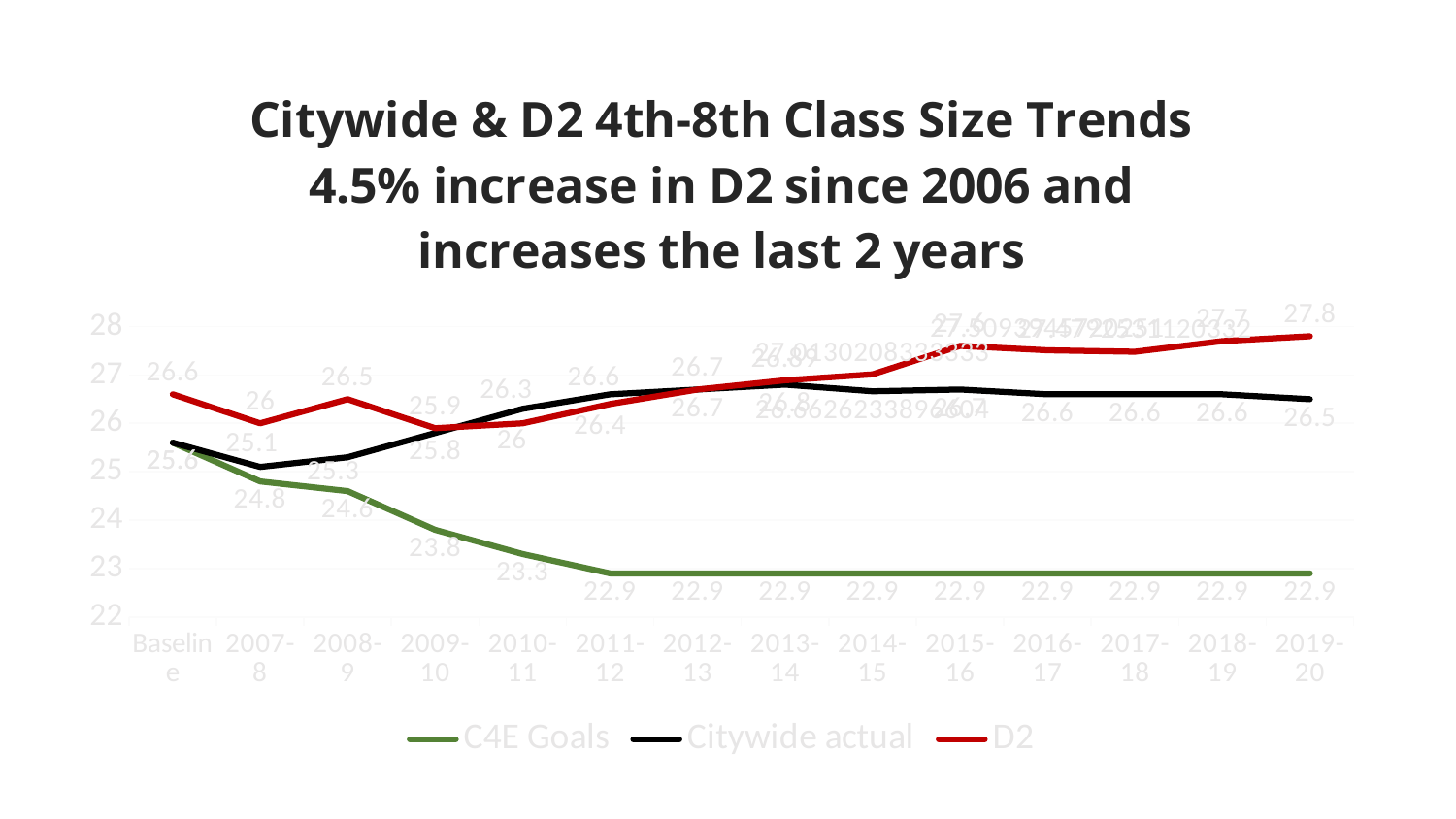
How many categories are shown along the x axis? 14 What is the D2 value for 2009-10? 25.9 How many series does the legend list? 3 What is the C4E Goals value for 2011-12? 22.9 In which year is the D2 value lowest? 2009-10 What is the difference between the D2 value and the Citywide actual value in 2019-20? 1.3 In 2008-9, which is larger: the D2 value or the Citywide actual value? D2 What is the D2 value for 2019-20? 27.8 Does the C4E Goals line generally rise or fall from Baseline to 2019-20? fall What kind of chart is shown on the slide? line chart What colour is the D2 line? red What is the Citywide actual value for 2007-8? 25.1